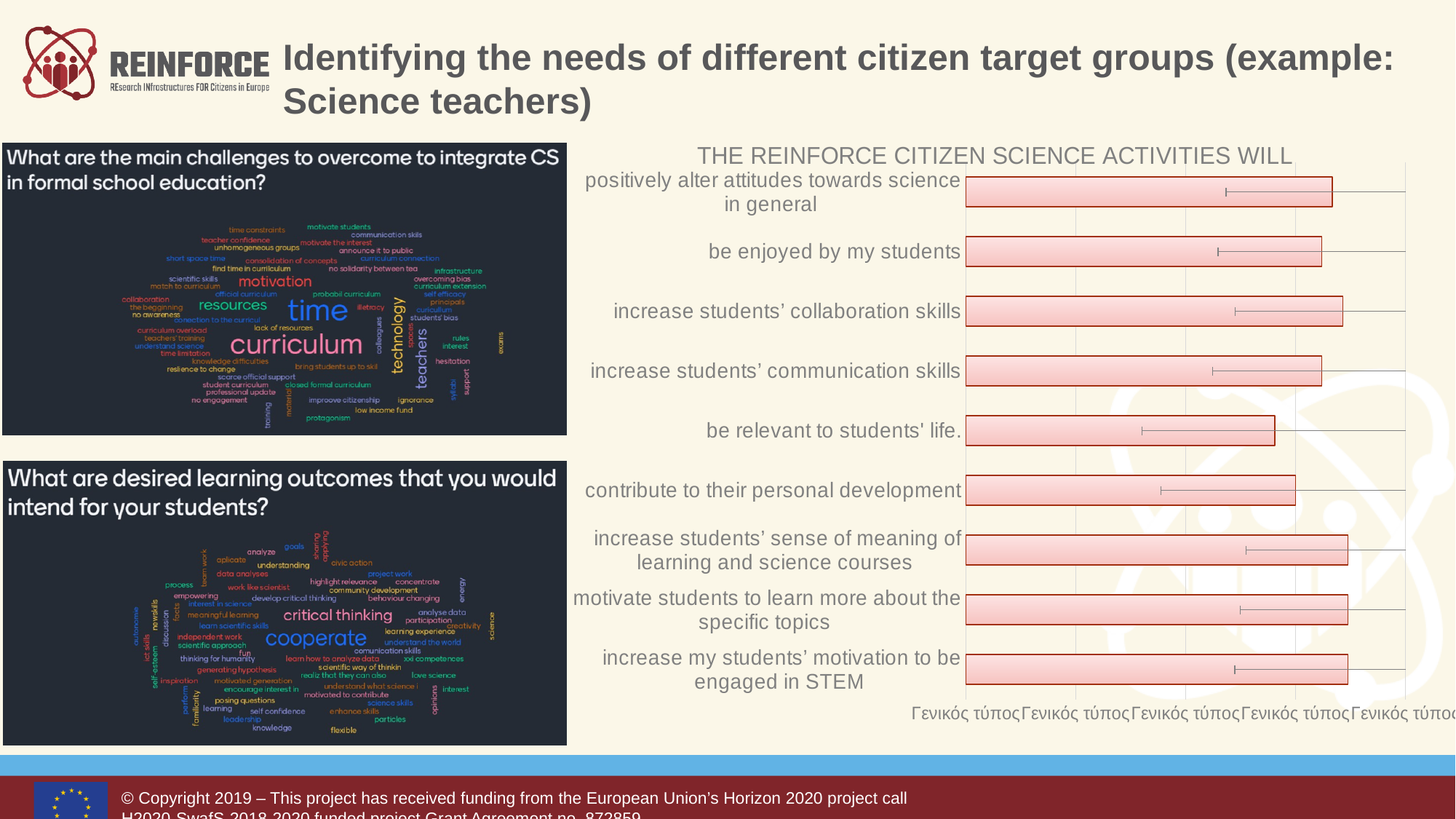
What kind of chart is shown on the right side of the slide? bar chart What is the title of the bar chart on the right side of the slide? THE REINFORCE CITIZEN SCIENCE ACTIVITIES WILL In the bar chart on the right, which bar is longer: 'contribute to their personal development' or 'increase students' collaboration skills'? increase students' collaboration skills How many categories (bars) does the bar chart on the right show? 9 Which category is listed at the top of the bar chart on the right? positively alter attitudes towards science in general In the bar chart on the right, which category has the shortest bar? be relevant to students' life. Are the bars in the chart on the right oriented horizontally or vertically? horizontally In the bar chart on the right, which bar is longer: 'be relevant to students' life.' or 'be enjoyed by my students'? be enjoyed by my students In the bar chart on the right, which bar is longer: 'be relevant to students' life.' or 'increase my students' motivation to be engaged in STEM'? increase my students' motivation to be engaged in STEM